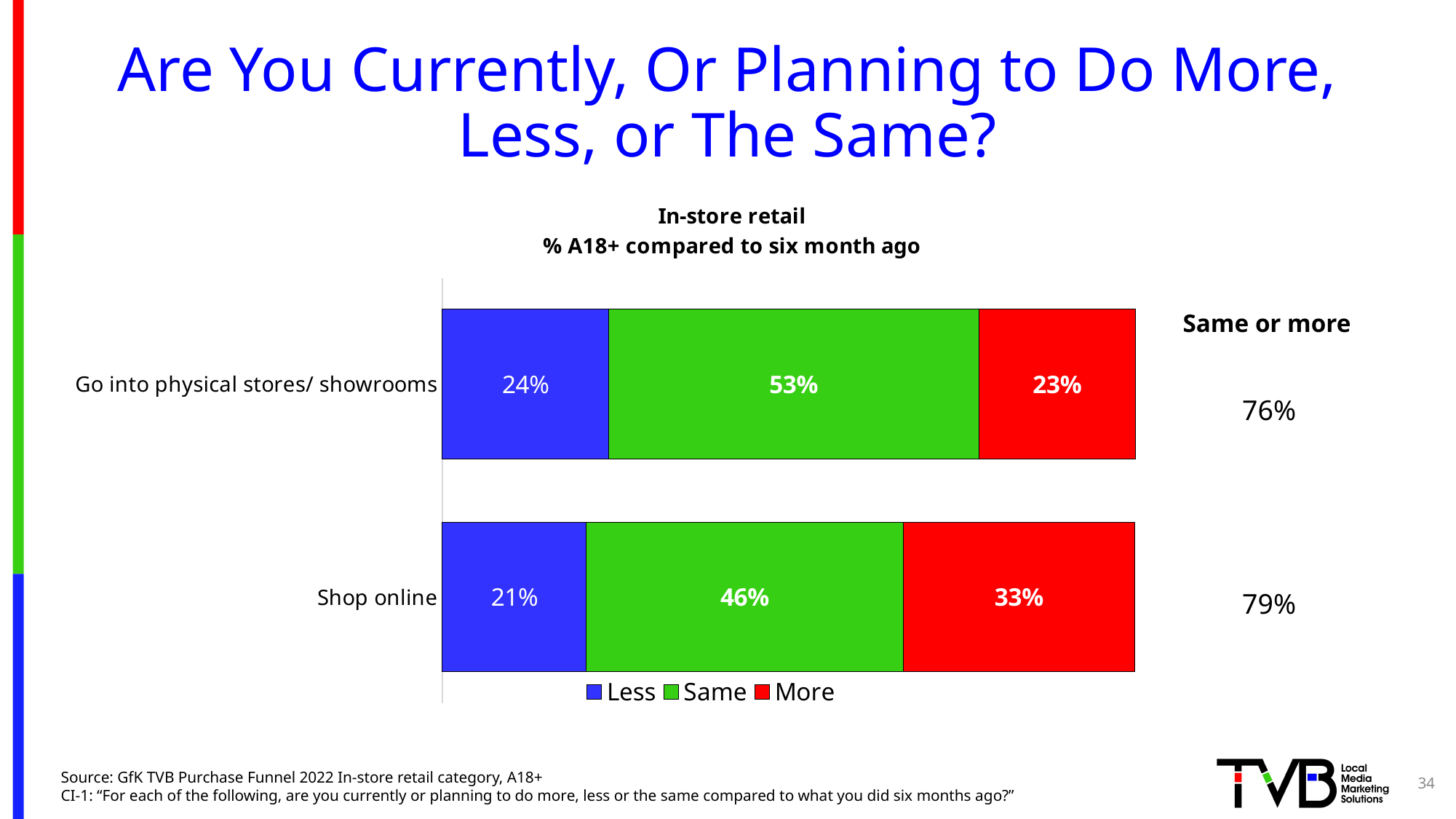
How many series does the legend list? 3 Which category has the larger 'More' share, Go into physical stores/showrooms or Shop online? Shop online What is the difference between the 'Same' share for Go into physical stores/showrooms and the 'Same' share for Shop online? 7% What is the 'Same or more' figure shown for Shop online? 79% What percentage of A18+ say they are shopping online more? 33% What kind of chart is shown on the slide? Stacked bar chart What percentage of A18+ say they are doing the same amount of going into physical stores/showrooms? 53% What percentage of A18+ say they are going into physical stores/showrooms less? 24% What is the total of the three segments in the Shop online bar? 100% How many categories are plotted in the chart? 2 What is the difference between the 'More' share for Shop online and the 'More' share for Go into physical stores/showrooms? 10% Which colour represents the 'More' series in the chart? Red